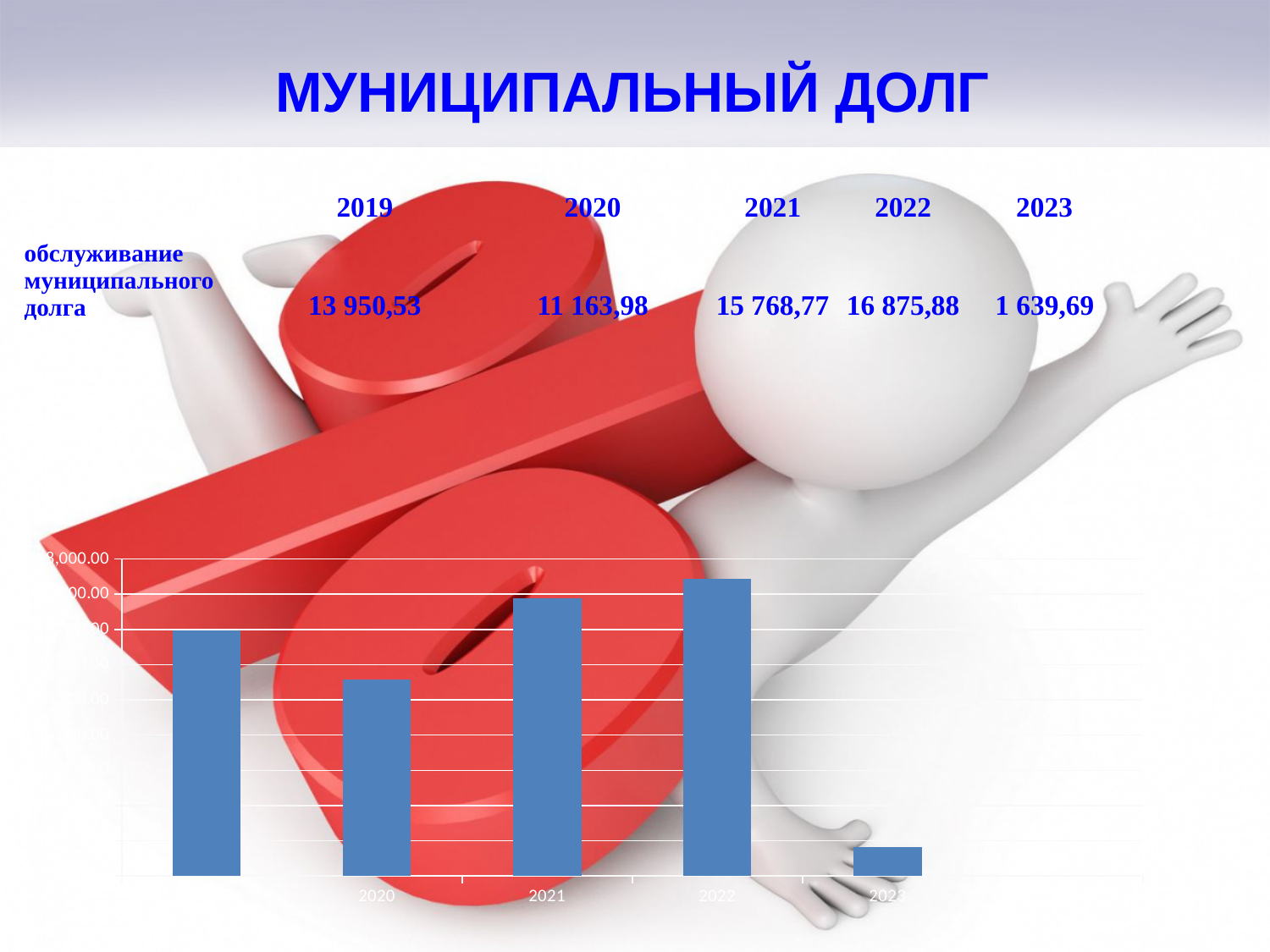
Which year has the lowest bar in the chart? 2023 What is the difference between the values for 2022 and 2021? 1 107,11 Does the value rise or fall from 2022 to 2023? fall What is the value for 2019 for обслуживание муниципального долга? 13 950,53 Which year has the highest bar in the chart? 2022 What kind of chart is shown on the slide? bar chart What is the title of the slide containing the chart? МУНИЦИПАЛЬНЫЙ ДОЛГ What is the value for 2023 for обслуживание муниципального долга? 1 639,69 Which is larger, the value for 2021 or the value for 2020? 2021 What is the value for 2020 for обслуживание муниципального долга? 11 163,98 How many bars does the chart contain? 5 What is the value for 2022 for обслуживание муниципального долга? 16 875,88